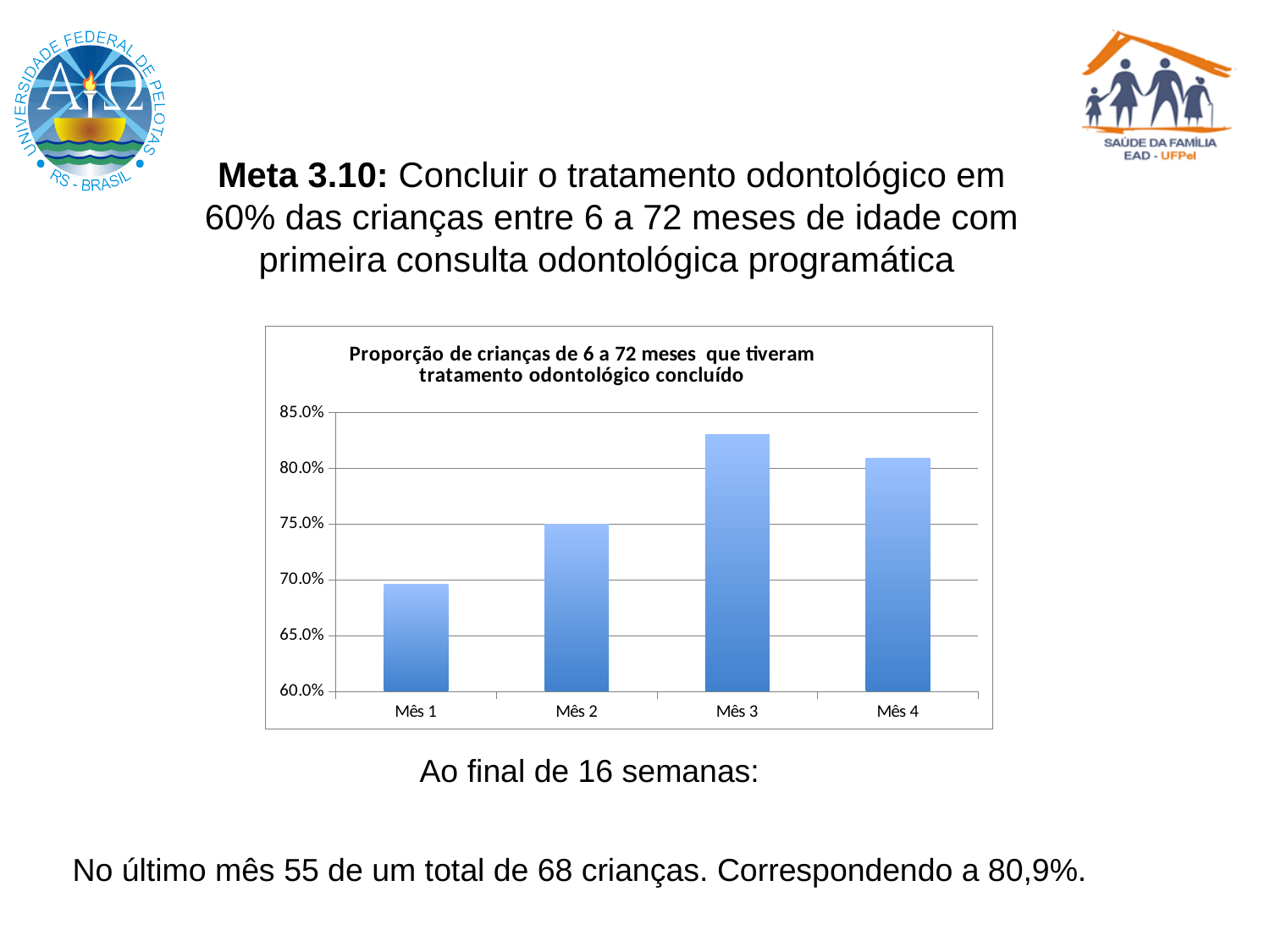
Is the value for Mês 3 greater or less than 80.0%? greater Is the value for Mês 1 greater or less than 65.0%? greater Is the value for Mês 3 greater or less than 85.0%? less Which is larger, the value for Mês 1 or the value for Mês 2? Mês 2 Which month has the highest proportion in the chart? Mês 3 Which is larger, the value for Mês 3 or the value for Mês 4? Mês 3 Do the values rise or fall from Mês 1 to Mês 3? rise Which month has the lowest proportion in the chart? Mês 1 How many months (categories) are shown on the x axis of the chart? 4 What is the title of the chart? Proporção de crianças de 6 a 72 meses que tiveram tratamento odontológico concluído What kind of chart is shown on the slide? bar chart